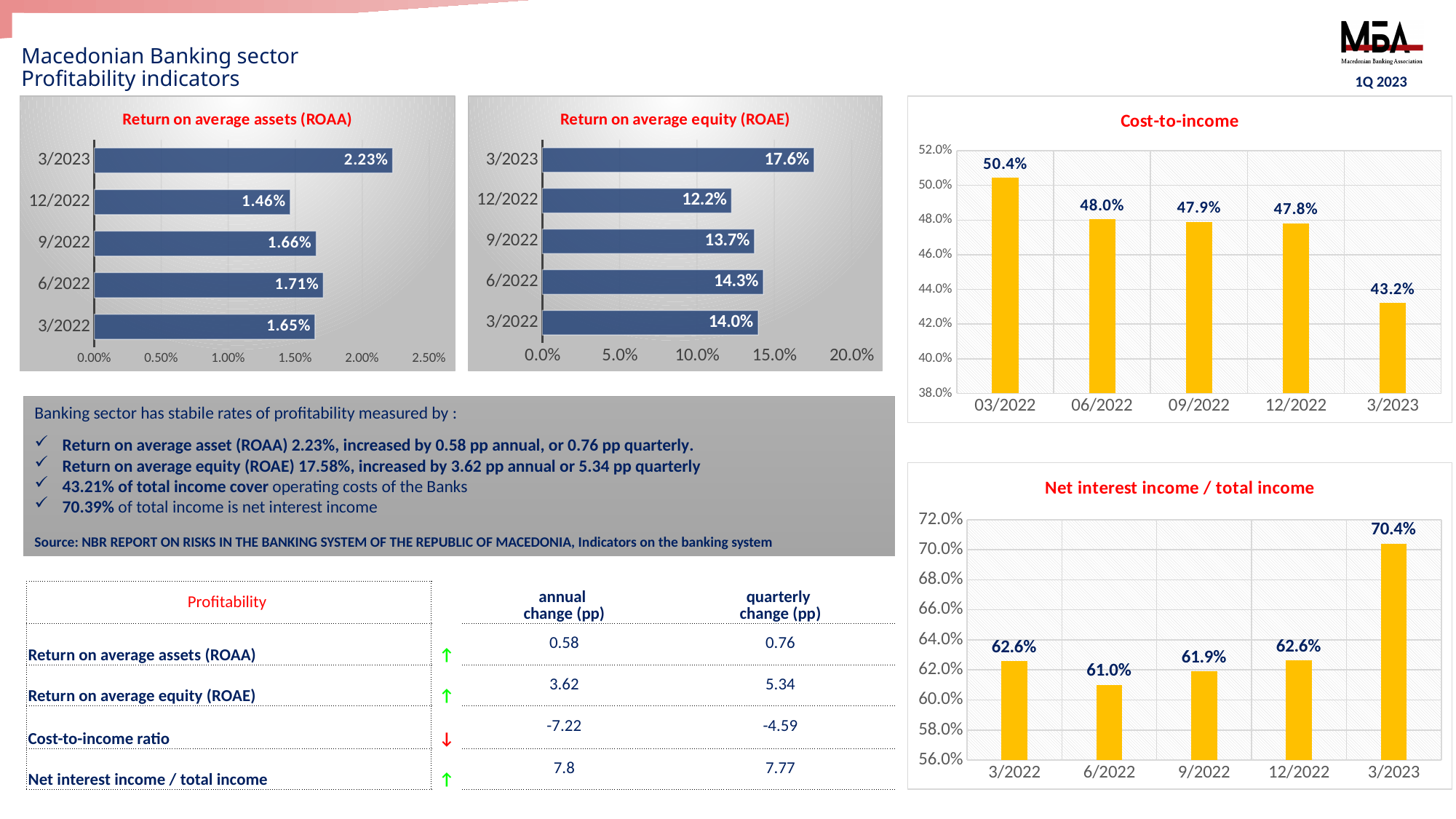
In the 'Return on average assets (ROAA)' chart, which period has the lowest value? 12/2022 In the 'Return on average equity (ROAE)' chart, which period has the highest value? 3/2023 In the 'Return on average equity (ROAE)' chart, what is the value for 9/2022? 13.7% In the 'Cost-to-income' chart, what is the value for 06/2022? 48.0% In the 'Net interest income / total income' chart, what is the value for 6/2022? 61.0% In the 'Cost-to-income' chart, which period has the lowest value? 3/2023 In the 'Net interest income / total income' chart, which is larger, the value for 9/2022 or the value for 12/2022? 12/2022 How many periods are shown in the 'Net interest income / total income' chart? 5 In the 'Return on average equity (ROAE)' chart, what is the difference between the 3/2023 and 12/2022 values? 5.4 percentage points What kind of chart is the 'Return on average assets (ROAA)' chart? bar chart In the 'Return on average assets (ROAA)' chart, what is the value for 3/2023? 2.23% In the 'Cost-to-income' chart, do the values rise or fall from 03/2022 to 3/2023? fall